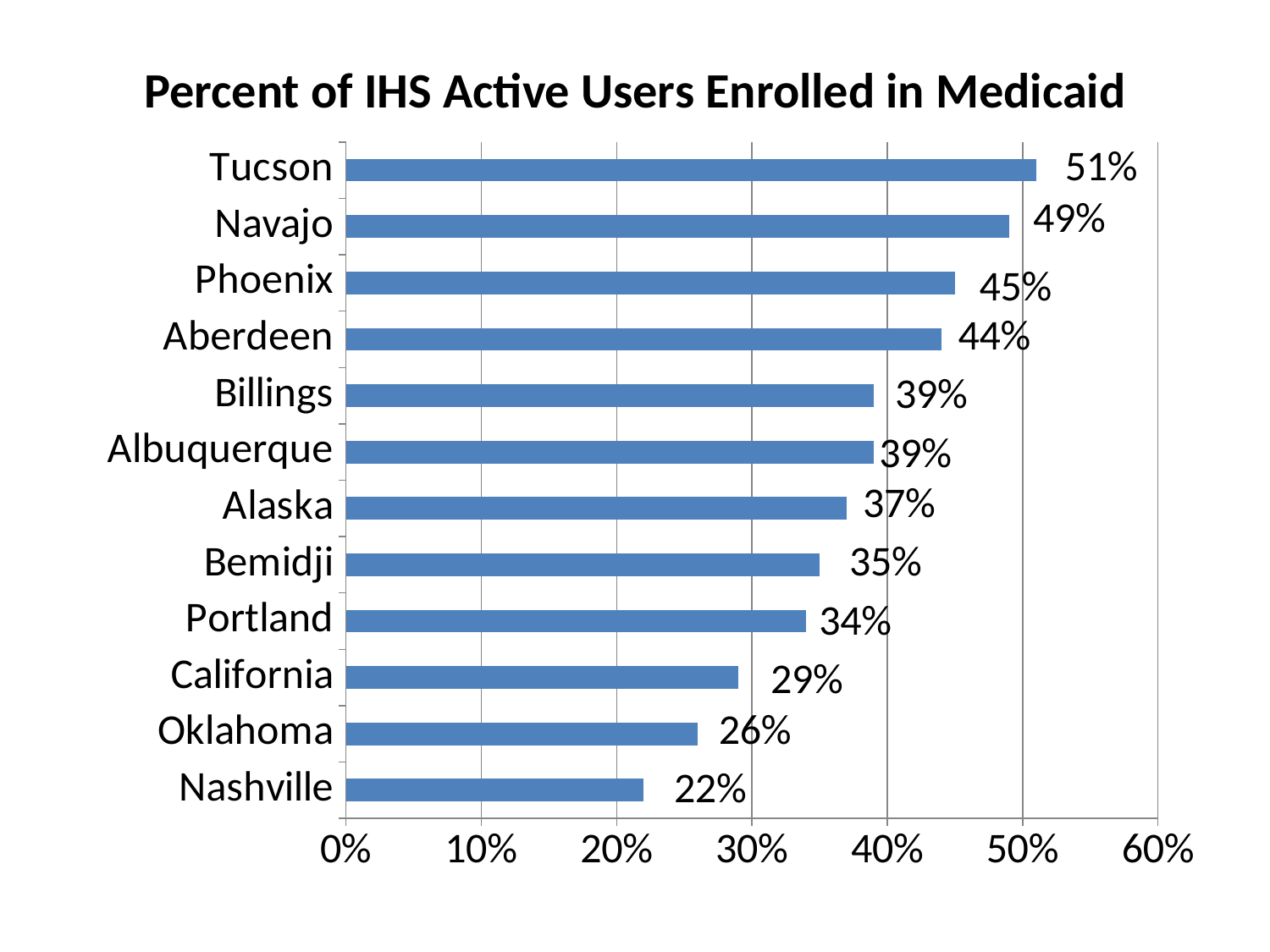
Which has a larger value, California or Alaska? Alaska How many areas are shown in the chart? 12 What is the difference between the values for Phoenix and Portland? 11% What is the value shown for Bemidji? 35% What is the percent of IHS active users enrolled in Medicaid for Tucson? 51% What kind of chart is shown on the slide? Bar chart Which area has the highest percent of IHS active users enrolled in Medicaid? Tucson What is the value shown for Oklahoma? 26% What is the difference between the values for Tucson and Nashville? 29% Which area has the lowest percent of IHS active users enrolled in Medicaid? Nashville What is the title of the chart? Percent of IHS Active Users Enrolled in Medicaid Which has a larger value, Navajo or Aberdeen? Navajo